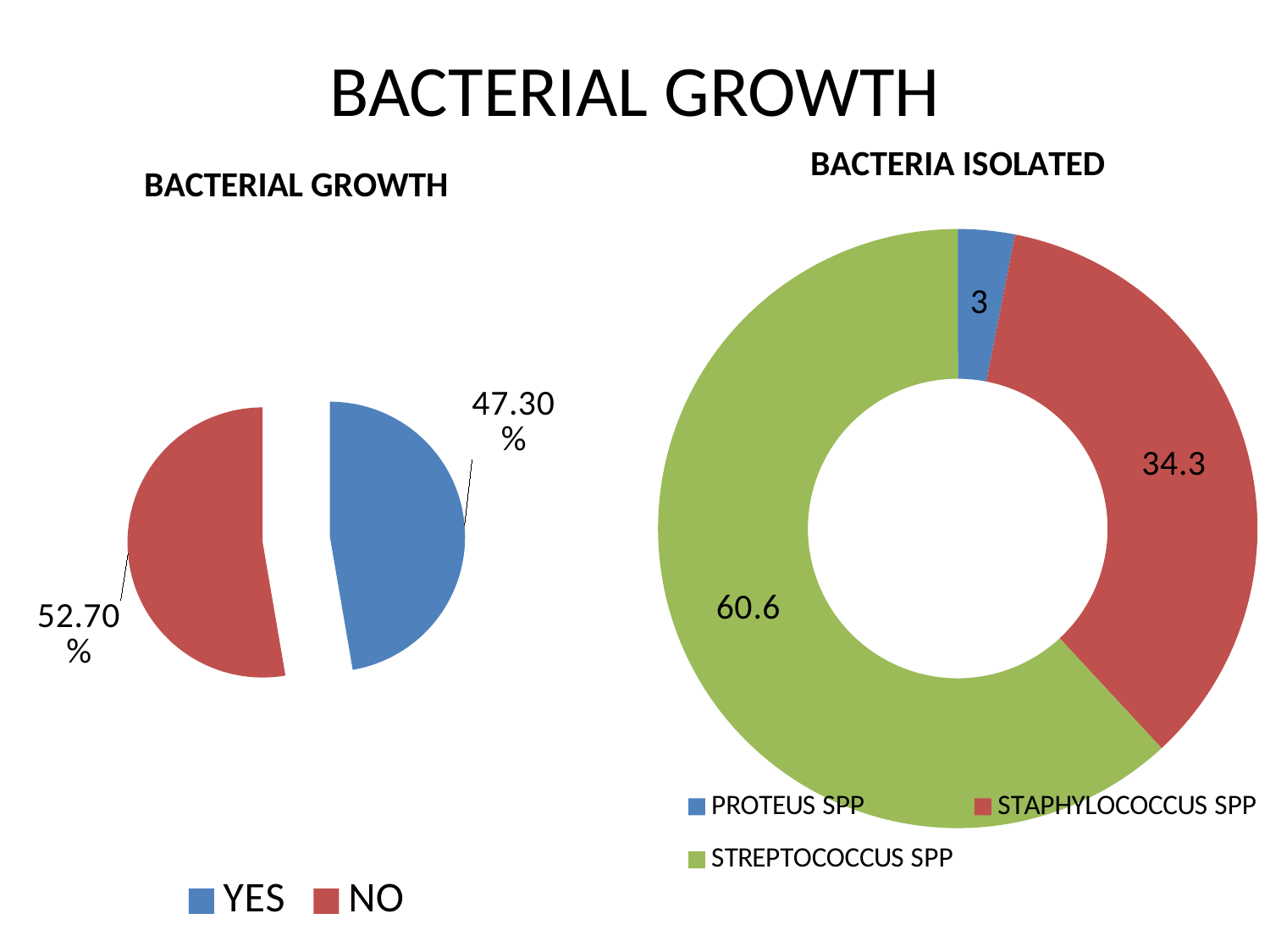
How many categories does the legend of the BACTERIAL GROWTH chart list? 2 In the BACTERIA ISOLATED chart, what is the value for STREPTOCOCCUS SPP? 60.6 In the BACTERIA ISOLATED chart, what is the value for STAPHYLOCOCCUS SPP? 34.3 In the BACTERIAL GROWTH chart, what is the value for NO? 52.70% In the BACTERIA ISOLATED chart, what is the difference between STREPTOCOCCUS SPP and STAPHYLOCOCCUS SPP? 26.3 In the BACTERIA ISOLATED chart, what colour represents STREPTOCOCCUS SPP? Green In the BACTERIA ISOLATED chart, which category has the smallest value? PROTEUS SPP What kind of chart is the BACTERIAL GROWTH chart? Pie chart In the BACTERIAL GROWTH chart, what is the value for YES? 47.30% In the BACTERIA ISOLATED chart, what is the value for PROTEUS SPP? 3 In the BACTERIAL GROWTH chart, what is the difference between the NO and YES values? 5.40% In the BACTERIAL GROWTH chart, which category has the larger share, YES or NO? NO